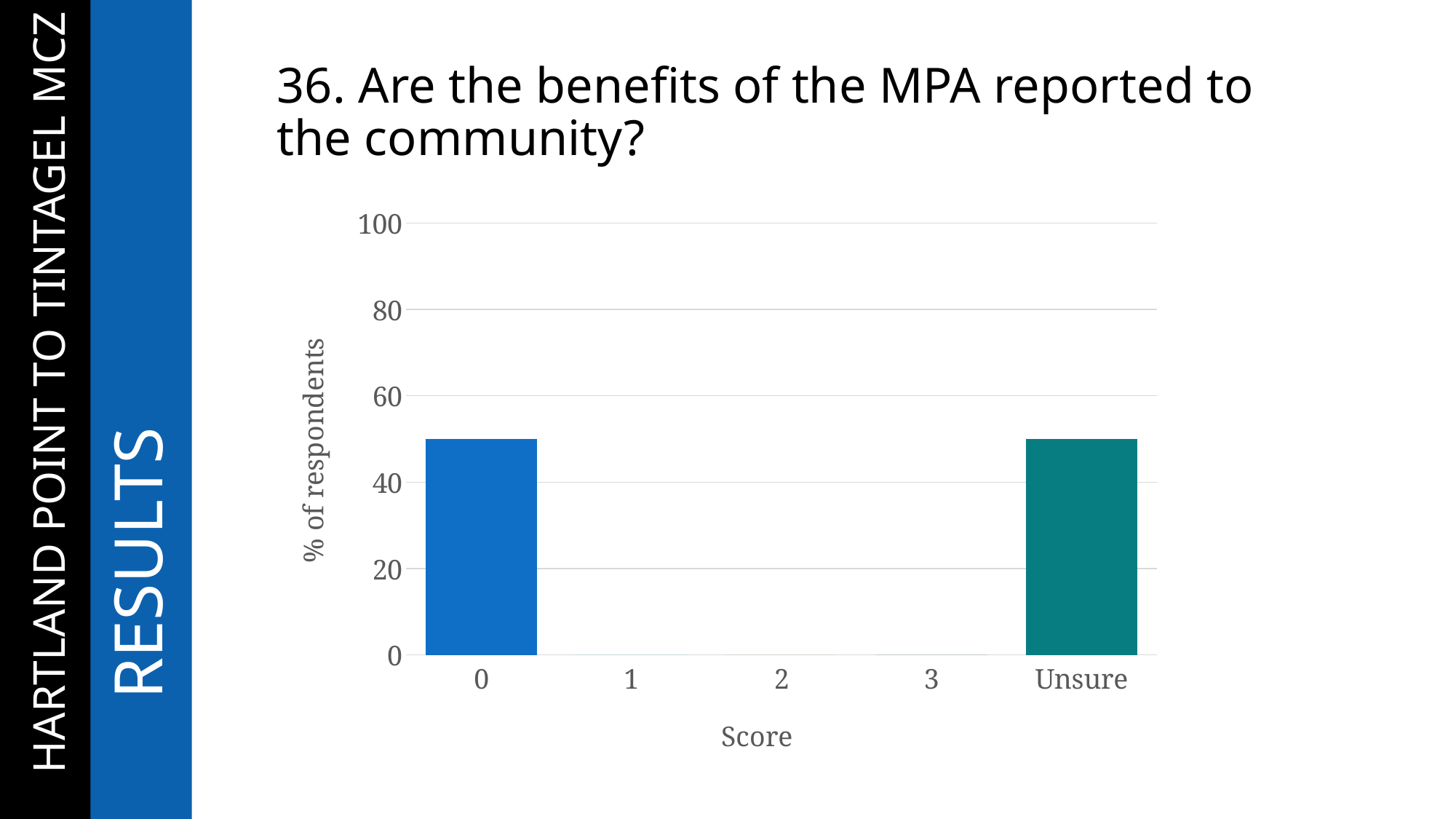
What is the label of the y axis? % of respondents Is the value for score 1 greater or less than 20? less How many categories are shown on the x axis of the chart? 5 Is the value for score 0 greater or less than 80? less Is the value for Unsure greater or less than 40? greater What is the value for score 2? 0 Which categories on the x axis have no visible bar? 1, 2 and 3 What kind of chart is shown on the slide? bar chart